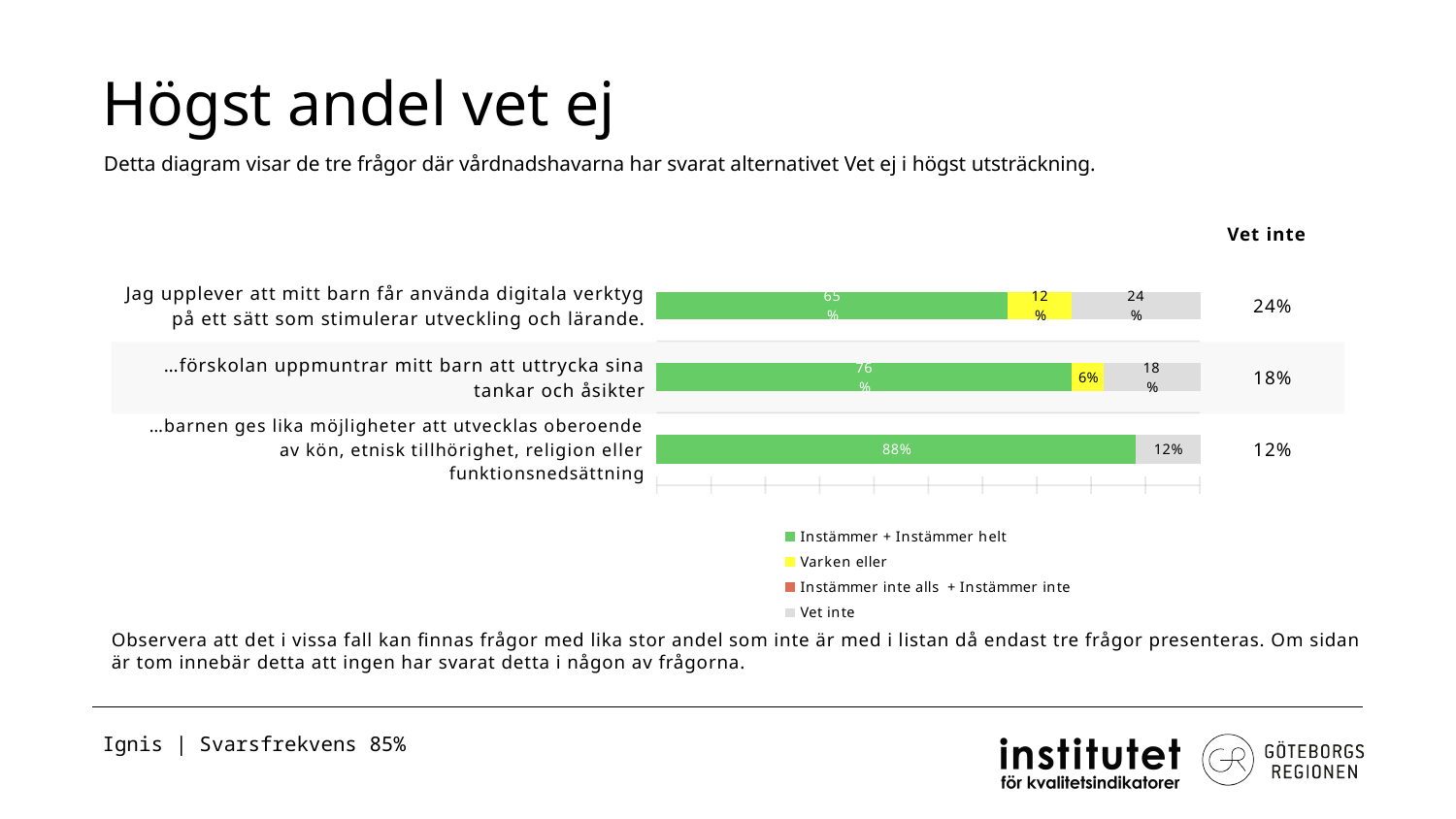
Which is larger: the 'Instämmer + Instämmer helt' value for '…förskolan uppmuntrar mitt barn att uttrycka sina tankar och åsikter' or for 'Jag upplever att mitt barn får använda digitala verktyg…'? …förskolan uppmuntrar mitt barn att uttrycka sina tankar och åsikter What colour represents 'Vet inte' in the chart? grey How many questions (categories) are plotted in the chart? 3 What kind of chart is shown on the slide? stacked bar chart What is the 'Varken eller' value for '…förskolan uppmuntrar mitt barn att uttrycka sina tankar och åsikter'? 6% What is the difference between the 'Vet inte' values for the first question (24%) and the third question (12%)? 12% What is the total of the stacked bar for '…förskolan uppmuntrar mitt barn att uttrycka sina tankar och åsikter' (76% + 6% + 18%)? 100% What is the 'Vet inte' value for 'Jag upplever att mitt barn får använda digitala verktyg på ett sätt som stimulerar utveckling och lärande'? 24% Which question has the highest 'Vet inte' share? Jag upplever att mitt barn får använda digitala verktyg på ett sätt som stimulerar utveckling och lärande What is the 'Instämmer + Instämmer helt' value for '…barnen ges lika möjligheter att utvecklas oberoende av kön, etnisk tillhörighet, religion eller funktionsnedsättning'? 88% How many series does the legend list? 4 Which question has the lowest 'Instämmer + Instämmer helt' share? Jag upplever att mitt barn får använda digitala verktyg på ett sätt som stimulerar utveckling och lärande